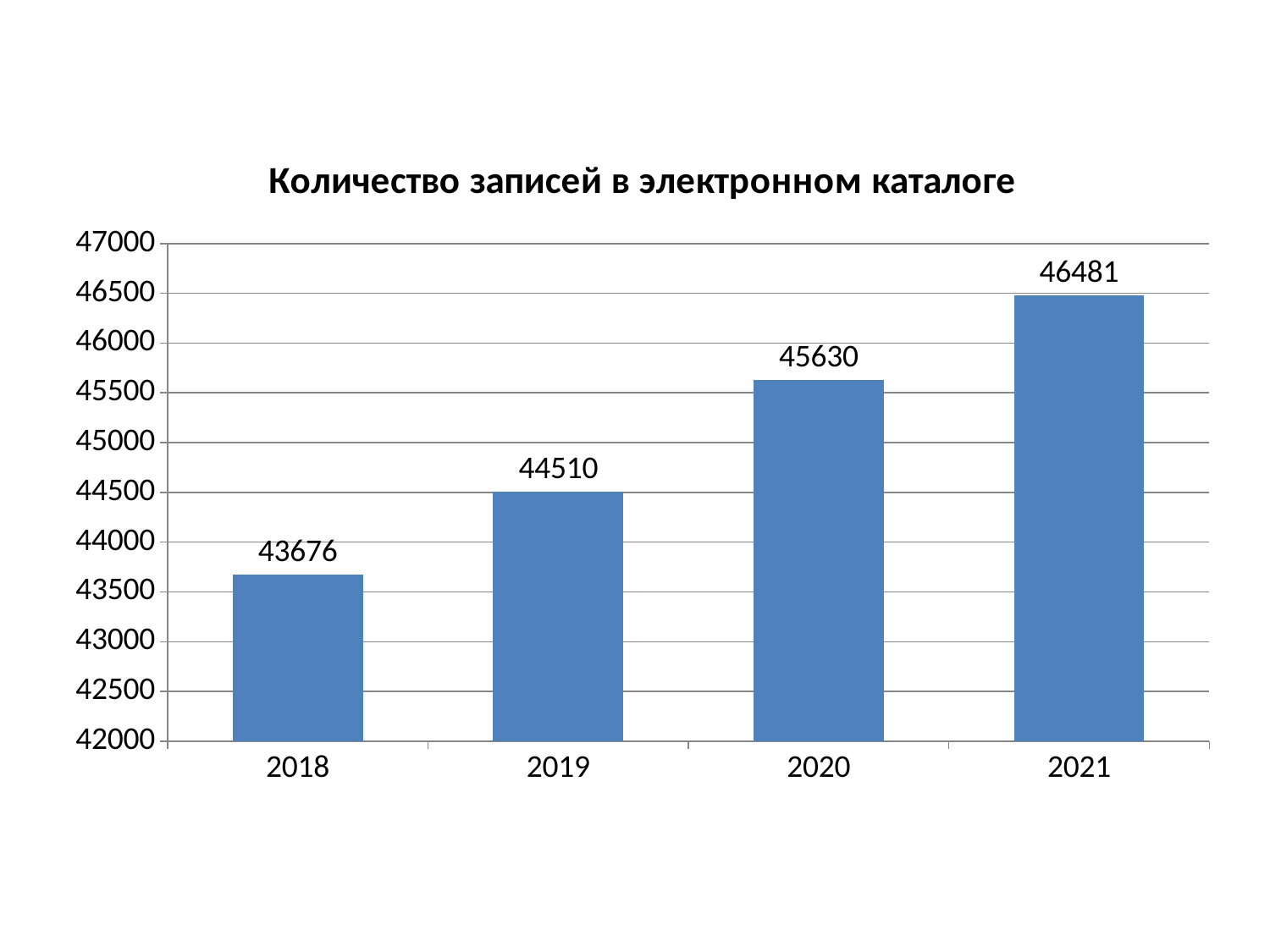
What is the difference between the values for 2020 and 2019? 1120 What kind of chart is this? bar chart What is the difference between the values for 2021 and 2018? 2805 What is the value for 2019? 44510 What is the value for 2020? 45630 What is the value for 2021? 46481 Which year has the lowest value? 2018 How many years are shown on the x axis? 4 Which year has the highest value? 2021 Which is larger, the value for 2019 or the value for 2020? 2020 What is the value for 2018? 43676 Do the values rise or fall from 2018 to 2021? rise